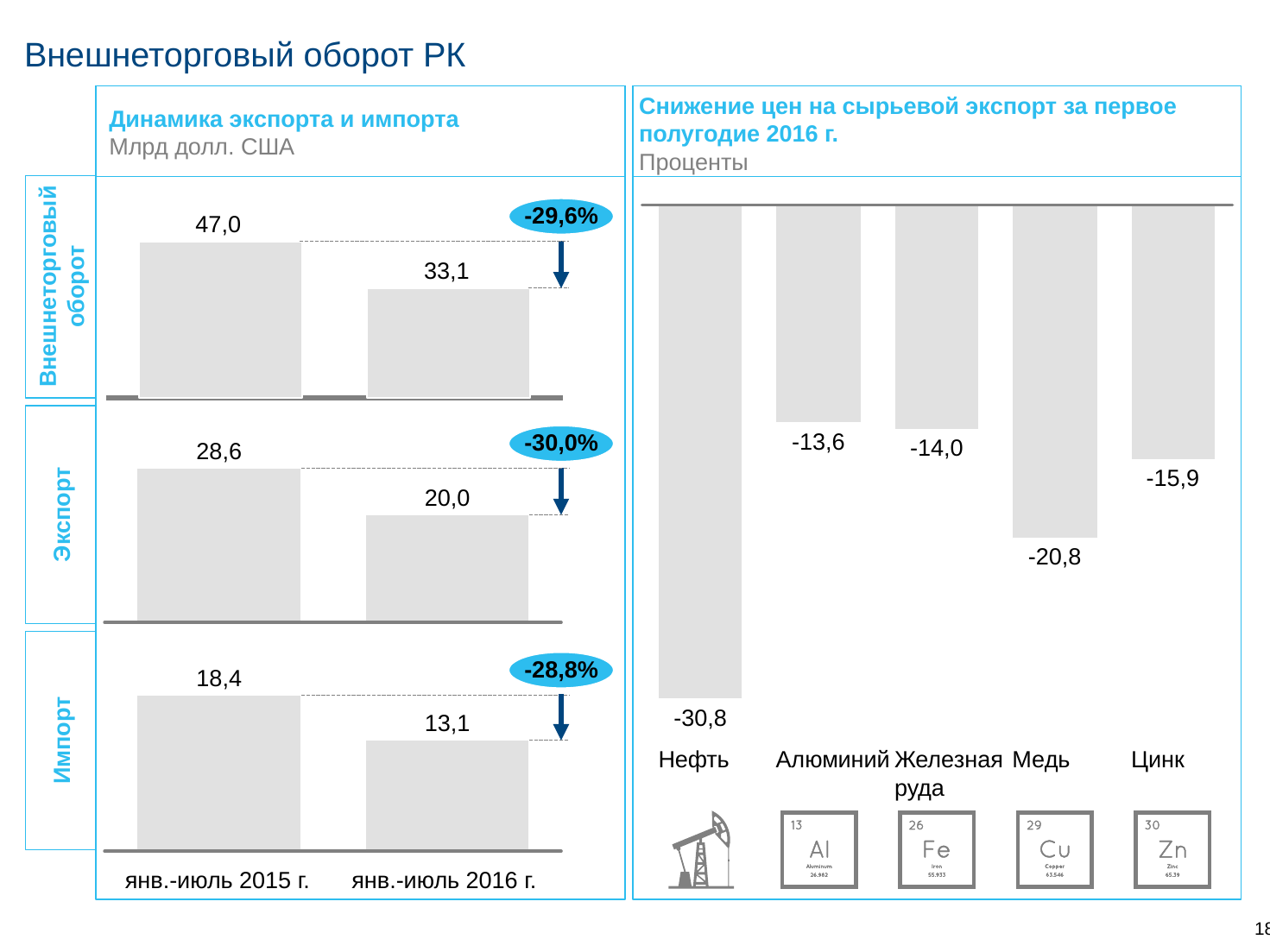
In the chart 'Динамика экспорта и импорта', what percentage change is shown for Импорт? -28,8% In the chart 'Динамика экспорта и импорта', what is the value of Импорт for янв.-июль 2015 г.? 18,4 In the chart 'Снижение цен на сырьевой экспорт за первое полугодие 2016 г.', which commodity shows the largest price decline? Нефть What type of chart is 'Снижение цен на сырьевой экспорт за первое полугодие 2016 г.'? Bar chart In the chart 'Снижение цен на сырьевой экспорт за первое полугодие 2016 г.', which commodity shows the smallest price decline? Алюминий In the chart 'Снижение цен на сырьевой экспорт за первое полугодие 2016 г.', what is the value for Медь? -20,8 In the chart 'Снижение цен на сырьевой экспорт за первое полугодие 2016 г.', what is the value for Нефть? -30,8 In the chart 'Динамика экспорта и импорта', which is larger: Экспорт in янв.-июль 2015 г. or Импорт in янв.-июль 2015 г.? Экспорт in янв.-июль 2015 г. In the chart 'Динамика экспорта и импорта', what is the value of Внешнеторговый оборот for янв.-июль 2015 г.? 47,0 How many commodities are shown in the chart 'Снижение цен на сырьевой экспорт за первое полугодие 2016 г.'? 5 In the chart 'Динамика экспорта и импорта', what is the value of Экспорт for янв.-июль 2016 г.? 20,0 In the chart 'Динамика экспорта и импорта', by how much did Внешнеторговый оборот fall from янв.-июль 2015 г. to янв.-июль 2016 г. in billions of US dollars? 13,9